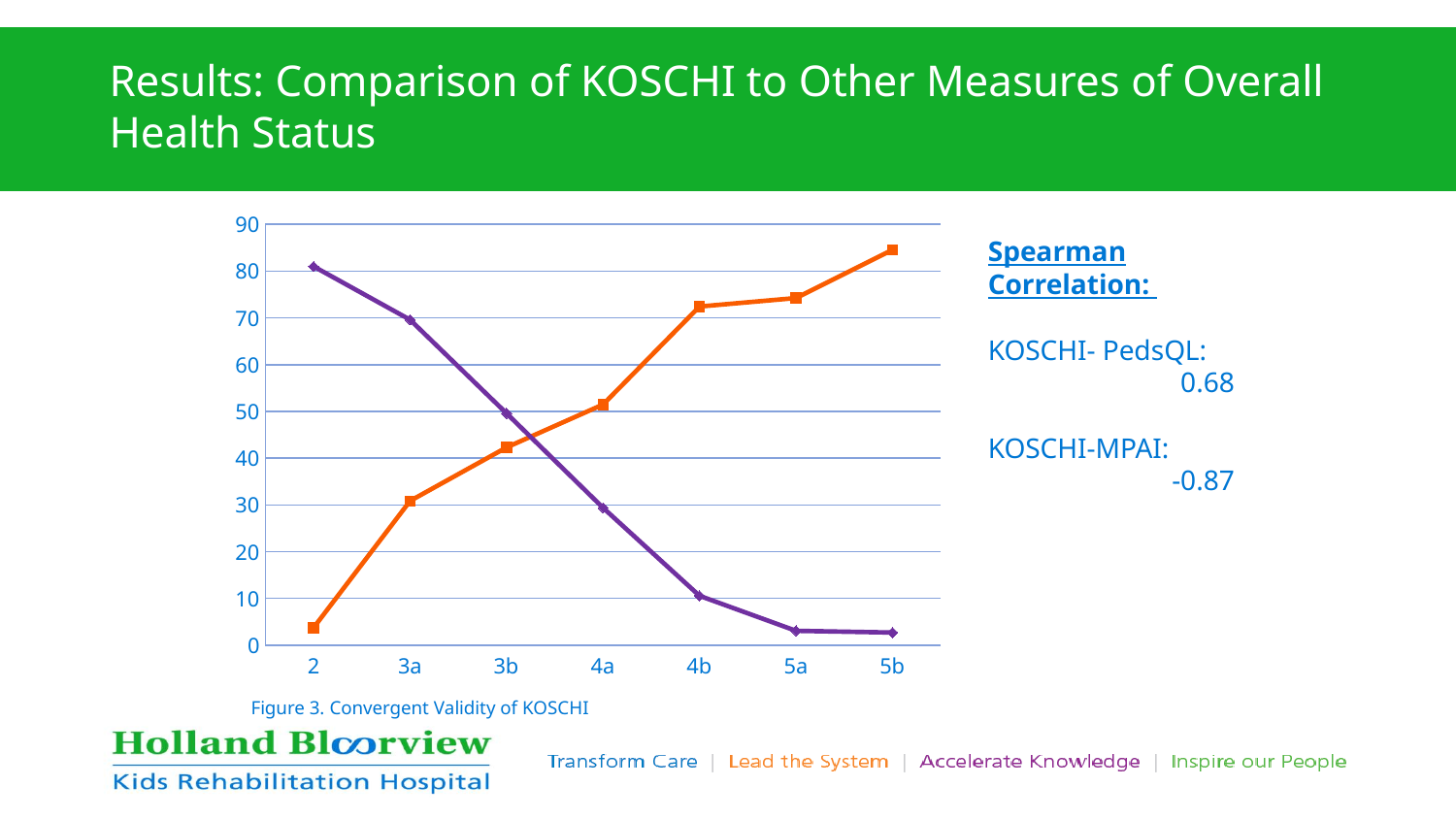
Is the value of the purple line at 5b greater or less than 10? less Is the value of the orange line at 5b greater or less than 80? greater At which x-axis category is the orange line highest? 5b At category 2, which line has the higher value, the purple line or the orange line? purple line How many lines are plotted on the chart? 2 Does the purple line rise or fall as you move from 2 to 5b along the x axis? fall At which x-axis category is the purple line highest? 2 What kind of chart is shown on the slide? line chart How many categories are shown on the x axis of the chart? 7 What is the figure caption shown below the chart? Figure 3. Convergent Validity of KOSCHI Does the orange line rise or fall as you move from 2 to 5b along the x axis? rise At which x-axis category is the orange line lowest? 2